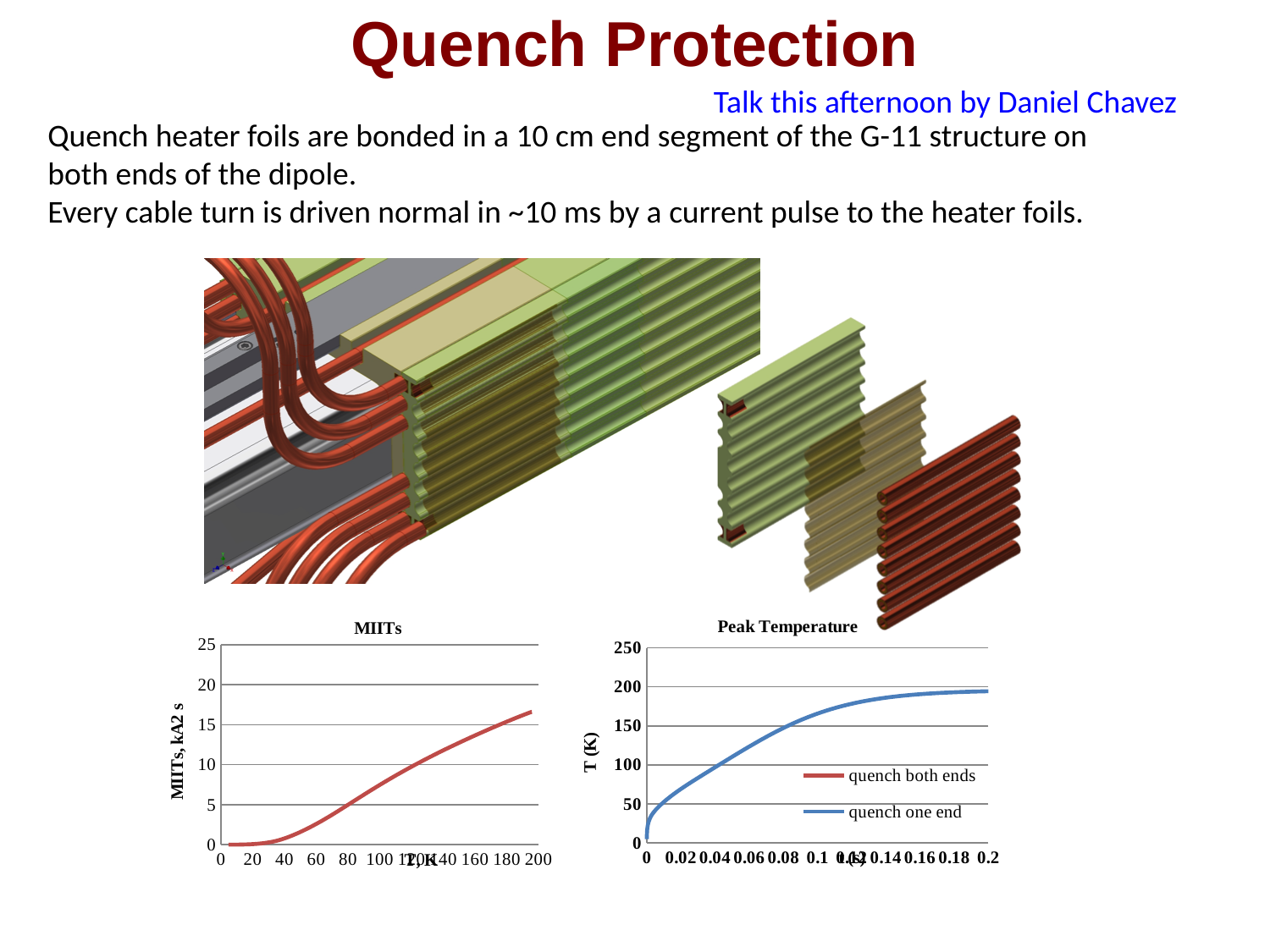
In the Peak Temperature chart, is the quench one end value at t = 0.02 s greater or less than 100? less What kind of chart is the Peak Temperature chart? line chart What are the two legend entries in the Peak Temperature chart? quench both ends, quench one end In the MIITs chart, do the values rise or fall as T increases along the x axis? rise In the MIITs chart, is the value at T = 100 K greater or less than 10? less What kind of chart is the MIITs chart? line chart How many series does the legend of the Peak Temperature chart list? 2 In the Peak Temperature chart, does the quench one end curve rise or fall as t increases? rise In the Peak Temperature chart, is the quench one end value at t = 0.2 s greater or less than 150? greater What is the y-axis title of the MIITs chart? MIITs, kA2 s